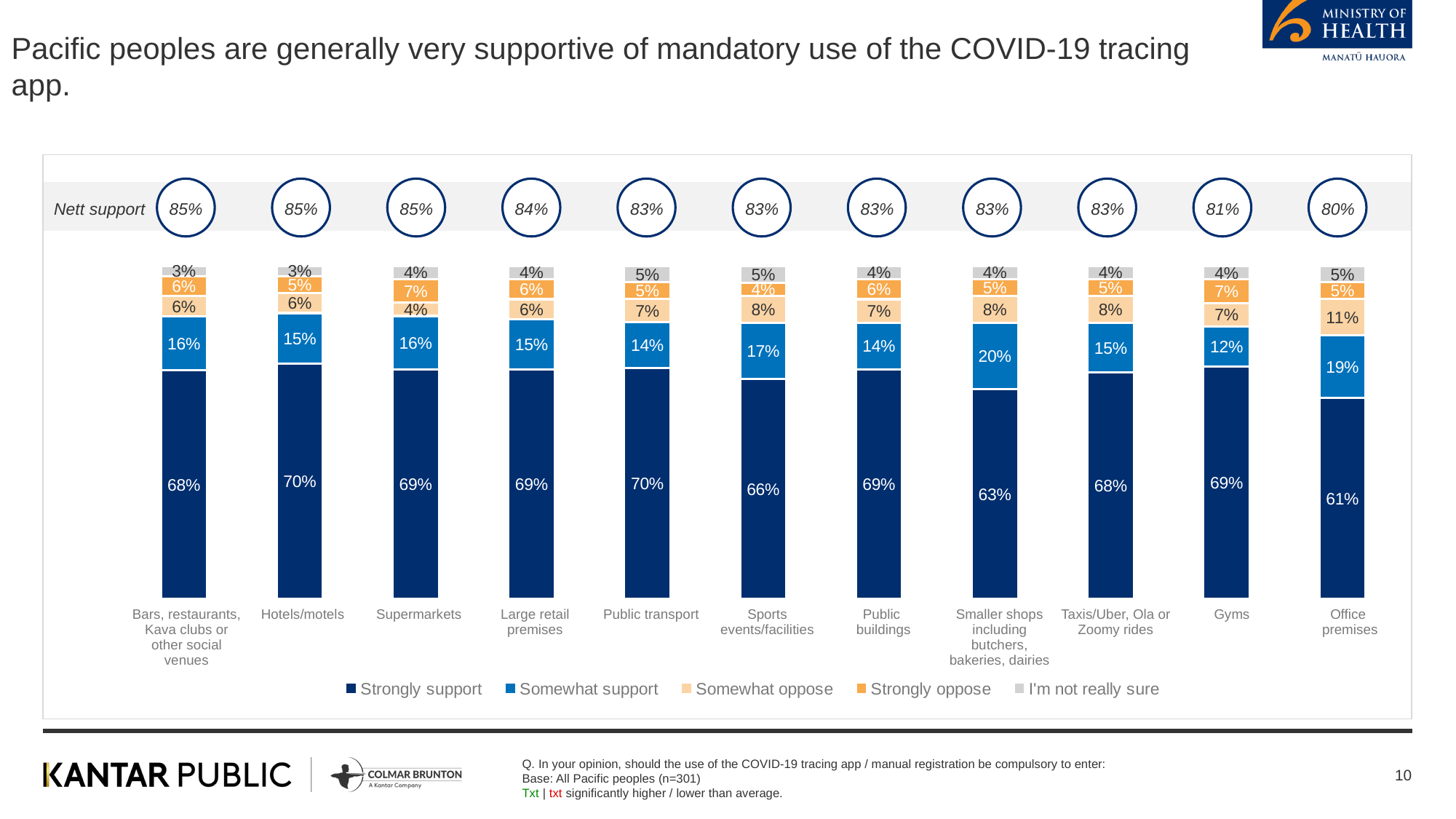
What kind of chart is shown on the slide? Stacked bar chart What percentage of Pacific peoples strongly support mandatory use of the tracing app for Office premises? 61% Which venue has the lowest Strongly support value? Office premises What is the Nett support figure shown for Gyms? 81% What is the Somewhat oppose value for Supermarkets? 4% How many venue categories are shown on the x axis? 11 Which has a larger Somewhat oppose value, Office premises or Gyms? Office premises What is the Somewhat support value for Smaller shops including butchers, bakeries, dairies? 20% How many series does the legend list? 5 Which venue has the highest Somewhat support value? Smaller shops including butchers, bakeries, dairies What is the 'I'm not really sure' value for Bars, restaurants, Kava clubs or other social venues? 3% What is the difference in Strongly support between Hotels/motels and Office premises? 9 percentage points